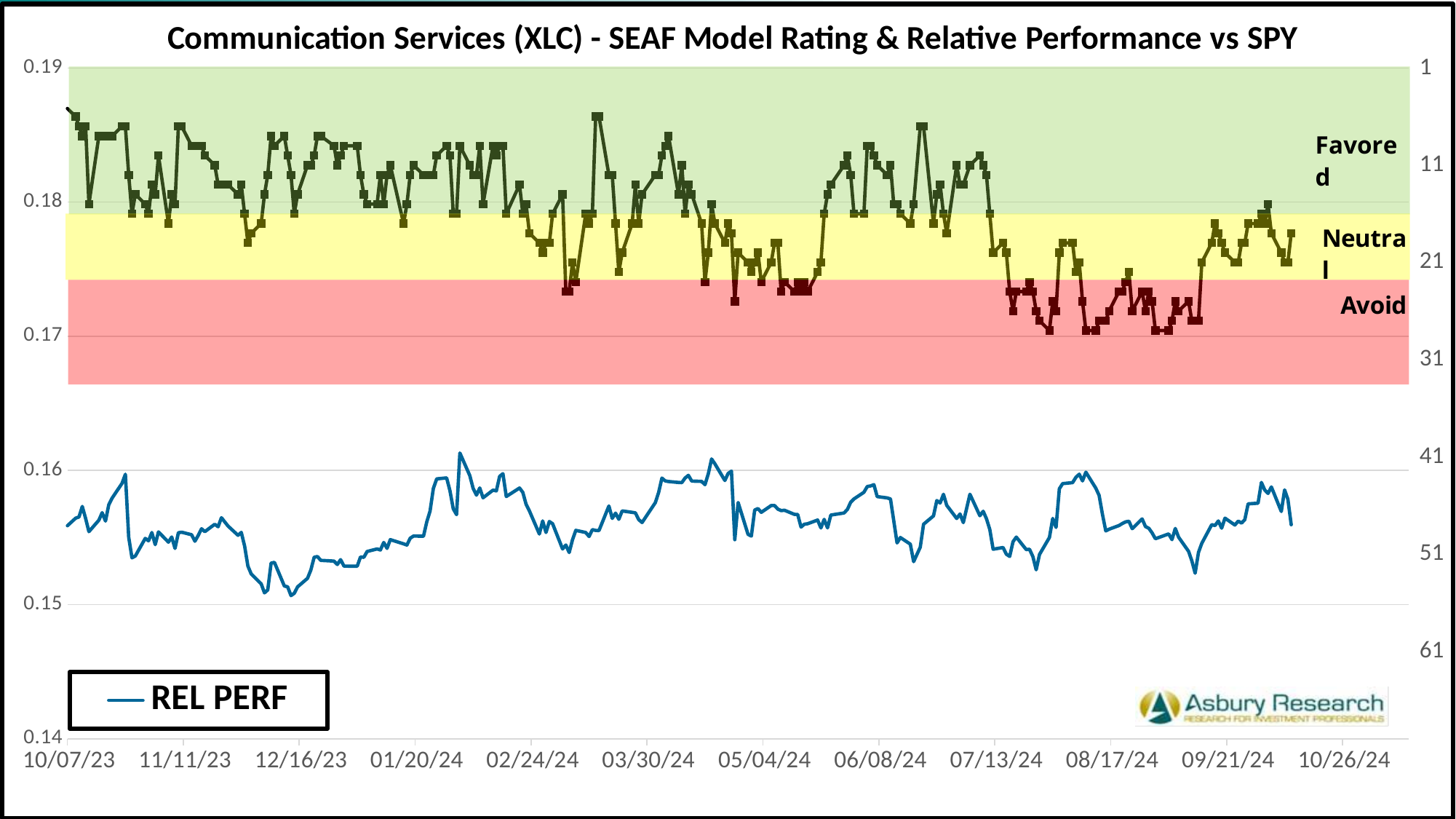
Is the REL PERF value at 10/07/23 greater or less than 0.16? less Does the REL PERF line rise or fall between 12/16/23 and 01/20/24? rise What is the name of the series shown in the legend? REL PERF How many series does the legend list? 1 What kind of chart is shown on the slide? line chart Which rating zone is the SEAF Model Rating in around 11/11/23? Favored How many date labels are shown on the x axis? 12 Is the SEAF Model Rating around 08/17/24 greater or less than 21 on the right axis? greater What is the title of the chart? Communication Services (XLC) - SEAF Model Rating & Relative Performance vs SPY Does the REL PERF line rise or fall between 10/07/23 and 12/16/23? fall